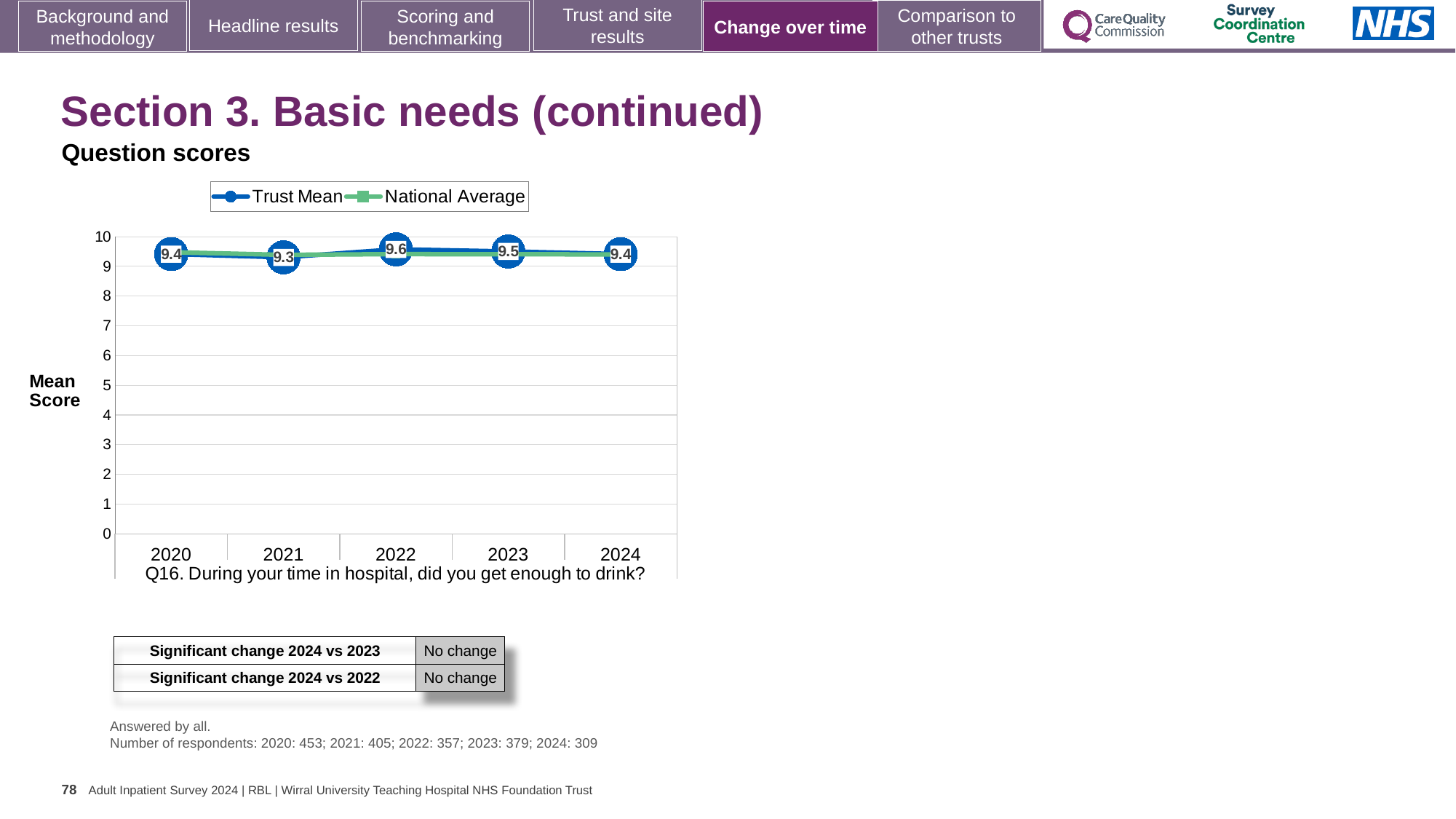
How many years are plotted on the x axis? 5 In which year is the Trust Mean score lowest? 2021 In which year is the Trust Mean score highest? 2022 What is the Trust Mean score for 2022? 9.6 What is the Trust Mean score for 2024? 9.4 What kind of chart is shown on the slide? line chart Which year has the larger Trust Mean score, 2023 or 2021? 2023 Does the Trust Mean score rise or fall from 2022 to 2024? fall What is the Trust Mean score for 2021? 9.3 How many series does the legend list? 2 What is the difference between the Trust Mean scores for 2022 and 2021? 0.3 Is the Trust Mean score for 2020 greater or less than 5? greater